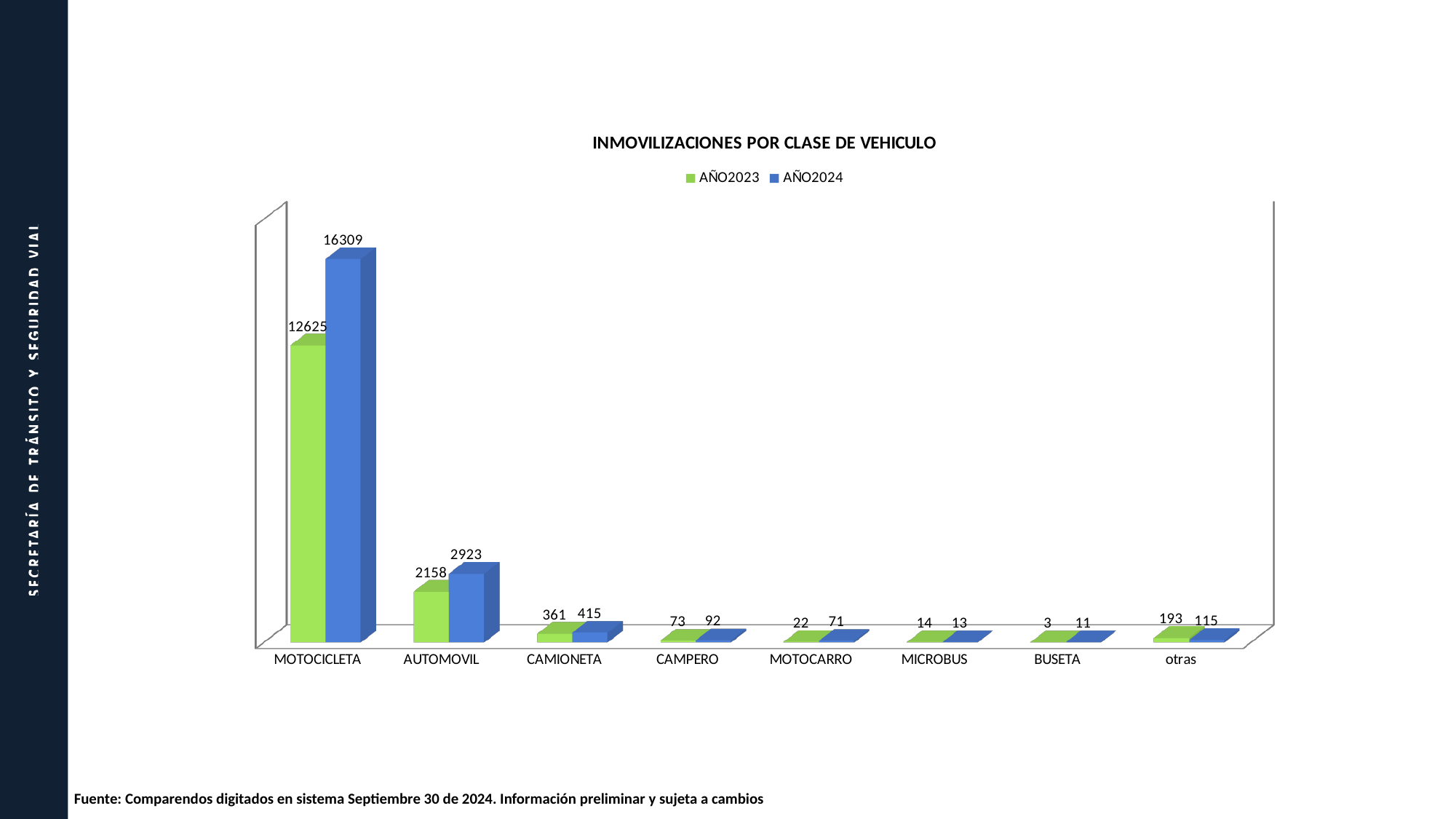
Which category has the highest value in the AÑO2024 series? MOTOCICLETA What is the difference between the AÑO2024 and AÑO2023 values for AUTOMOVIL? 765 What is the value for AUTOMOVIL in the AÑO2023 series? 2158 What is the value for BUSETA in the AÑO2023 series? 3 How many series does the legend list? 2 What is the value for CAMIONETA in the AÑO2024 series? 415 Which category has the lowest value in the AÑO2023 series? BUSETA What is the value for MOTOCICLETA in the AÑO2024 series? 16309 For MOTOCARRO, which series has the larger value, AÑO2023 or AÑO2024? AÑO2024 What is the difference between the AÑO2024 and AÑO2023 values for MOTOCICLETA? 3684 What kind of chart is shown on the slide? Bar chart How many vehicle categories are shown on the x axis? 8